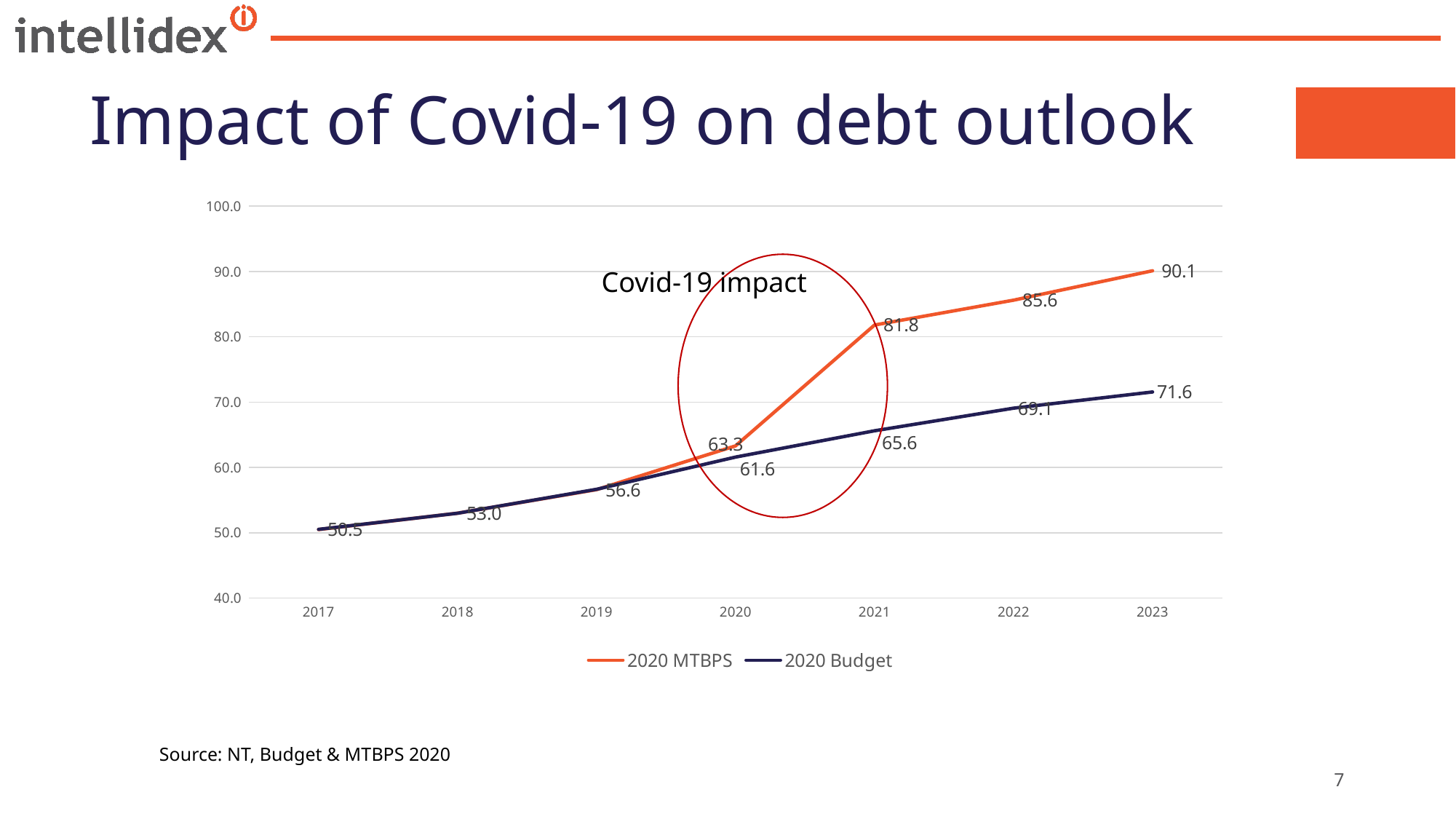
What type of chart is shown on the slide? line chart What is the value of the 2020 MTBPS series in 2021? 81.8 Do the values of the 2020 Budget series rise or fall from 2017 to 2023? rise What is the value of the 2020 Budget series in 2023? 71.6 What is the value of the 2020 MTBPS series in 2023? 90.1 In which year does the 2020 MTBPS series reach its highest value? 2023 How many years are shown on the x axis? 7 What is the difference between the 2020 MTBPS and 2020 Budget values in 2021? 16.2 How many series does the legend list? 2 What text is written inside the red circle annotation on the chart? Covid-19 impact What is the value of the 2020 Budget series in 2020? 61.6 Which series has the higher value in 2022, 2020 MTBPS or 2020 Budget? 2020 MTBPS